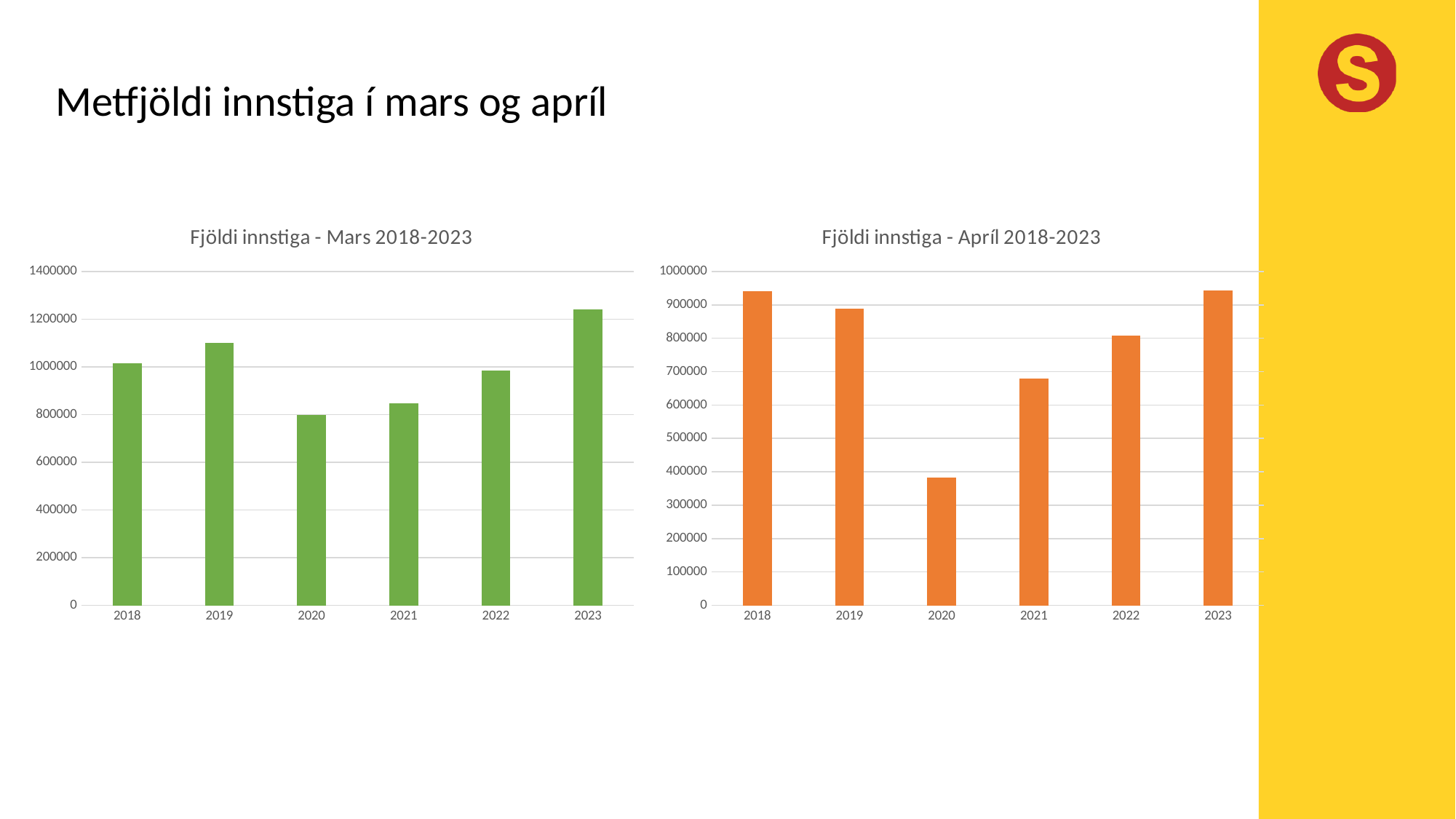
In the chart titled "Fjöldi innstiga - Apríl 2018-2023", which year has the lowest value? 2020 In the chart titled "Fjöldi innstiga - Mars 2018-2023", which year has the lowest value? 2020 In the chart titled "Fjöldi innstiga - Mars 2018-2023", which is larger, the value for 2019 or the value for 2022? 2019 What kind of chart is the chart titled "Fjöldi innstiga - Mars 2018-2023"? Bar chart In the chart titled "Fjöldi innstiga - Mars 2018-2023", is the value for 2023 greater or less than 1200000? greater In the chart titled "Fjöldi innstiga - Mars 2018-2023", which year has the highest value? 2023 In the chart titled "Fjöldi innstiga - Apríl 2018-2023", is the value for 2018 greater or less than 900000? greater How many years are shown on the x axis of the chart titled "Fjöldi innstiga - Apríl 2018-2023"? 6 In the chart titled "Fjöldi innstiga - Mars 2018-2023", is the value for 2022 greater or less than 1000000? less In the chart titled "Fjöldi innstiga - Apríl 2018-2023", do the values rise or fall from 2020 to 2023? Rise In the chart titled "Fjöldi innstiga - Apríl 2018-2023", which is larger, the value for 2021 or the value for 2022? 2022